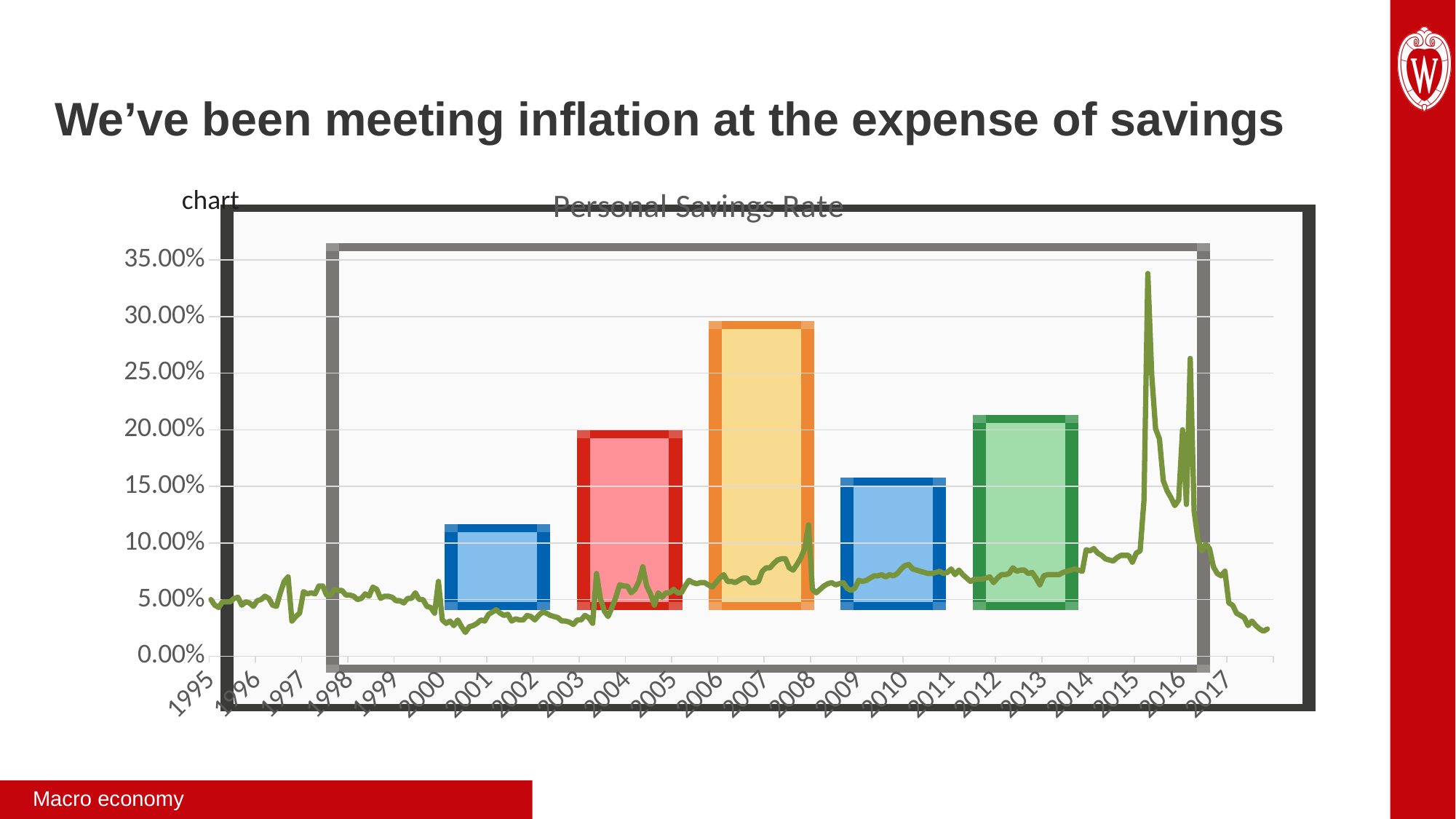
Does the personal savings rate generally rise or fall from 2000 to 2008? rise Is the personal savings rate around 2014 greater or less than 5.00%? greater Is the personal savings rate at the start of 1995 greater or less than 10.00%? less What is the highest value shown on the y axis of the chart? 35.00% Is the personal savings rate at the end of the line (2017) greater or less than 5.00%? less How many year labels are shown on the x axis of the chart? 23 What is the title of the chart? Personal Savings Rate Does the personal savings rate rise or fall from its peak around 2015 to the end of the line in 2017? fall What kind of chart is shown on the slide? line chart Is the peak of the personal savings rate line before or after 2010? after